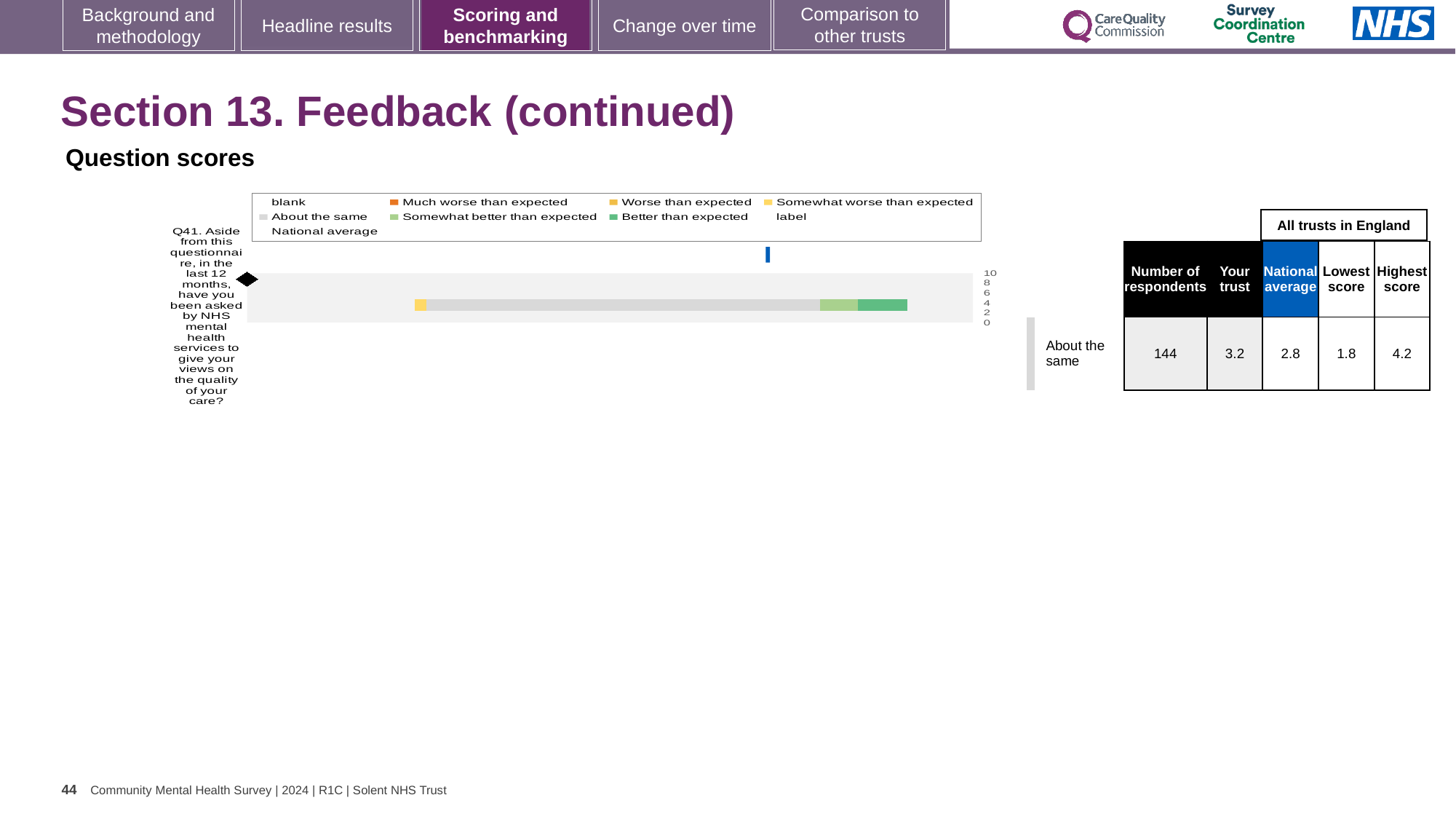
What is the difference between the highest score and the lowest score for Q41? 2.4 Which question is plotted in the chart? Q41. Aside from this questionnaire, in the last 12 months, have you been asked by NHS mental health services to give your views on the quality of your care? What is the number of respondents for Q41 shown in the table beside the chart? 144 What is the national average score for Q41 in the table beside the chart? 2.8 Which is larger for Q41, the 'Your trust' score or the national average? Your trust What colour represents 'Better than expected' in the chart legend? green How many entries does the chart legend list? 9 How many question categories are plotted in the chart? 1 What is the 'Your trust' score for Q41 in the table beside the chart? 3.2 What kind of chart is shown on the slide? bar chart What is the lowest score among all trusts in England for Q41? 1.8 What is the highest score among all trusts in England for Q41? 4.2